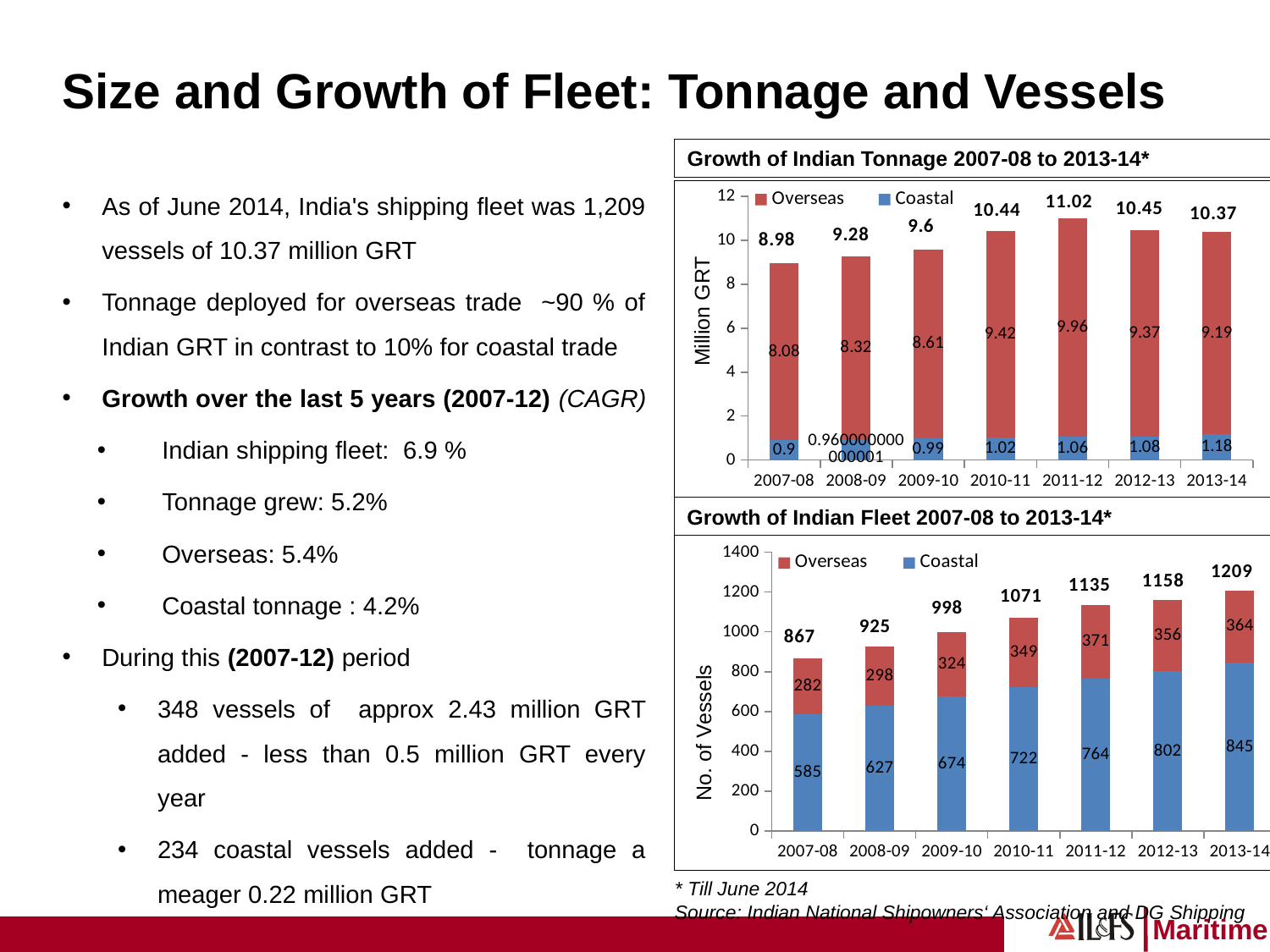
In the 'Growth of Indian Fleet 2007-08 to 2013-14*' chart, what is the total number of vessels for 2013-14? 1209 In the 'Growth of Indian Fleet 2007-08 to 2013-14*' chart, how many years are shown on the x axis? 7 In the 'Growth of Indian Fleet 2007-08 to 2013-14*' chart, is the Coastal value for 2012-13 larger than the Overseas value for 2012-13? Yes, Coastal (802) is larger In the 'Growth of Indian Fleet 2007-08 to 2013-14*' chart, what is the Coastal value for 2009-10? 674 What kind of chart is the 'Growth of Indian Fleet 2007-08 to 2013-14*' chart? Stacked bar chart In the 'Growth of Indian Tonnage 2007-08 to 2013-14*' chart, what is the total tonnage shown for 2011-12? 11.02 In the 'Growth of Indian Tonnage 2007-08 to 2013-14*' chart, which year has the highest total tonnage? 2011-12 In the 'Growth of Indian Tonnage 2007-08 to 2013-14*' chart, which year has the lowest total tonnage? 2007-08 In the 'Growth of Indian Fleet 2007-08 to 2013-14*' chart, which year has the highest Overseas value? 2011-12 In the 'Growth of Indian Tonnage 2007-08 to 2013-14*' chart, what is the difference between the Overseas values for 2011-12 and 2013-14? 0.77 In the 'Growth of Indian Tonnage 2007-08 to 2013-14*' chart, how many series does the legend list? 2 In the 'Growth of Indian Tonnage 2007-08 to 2013-14*' chart, what is the Overseas value for 2010-11? 9.42